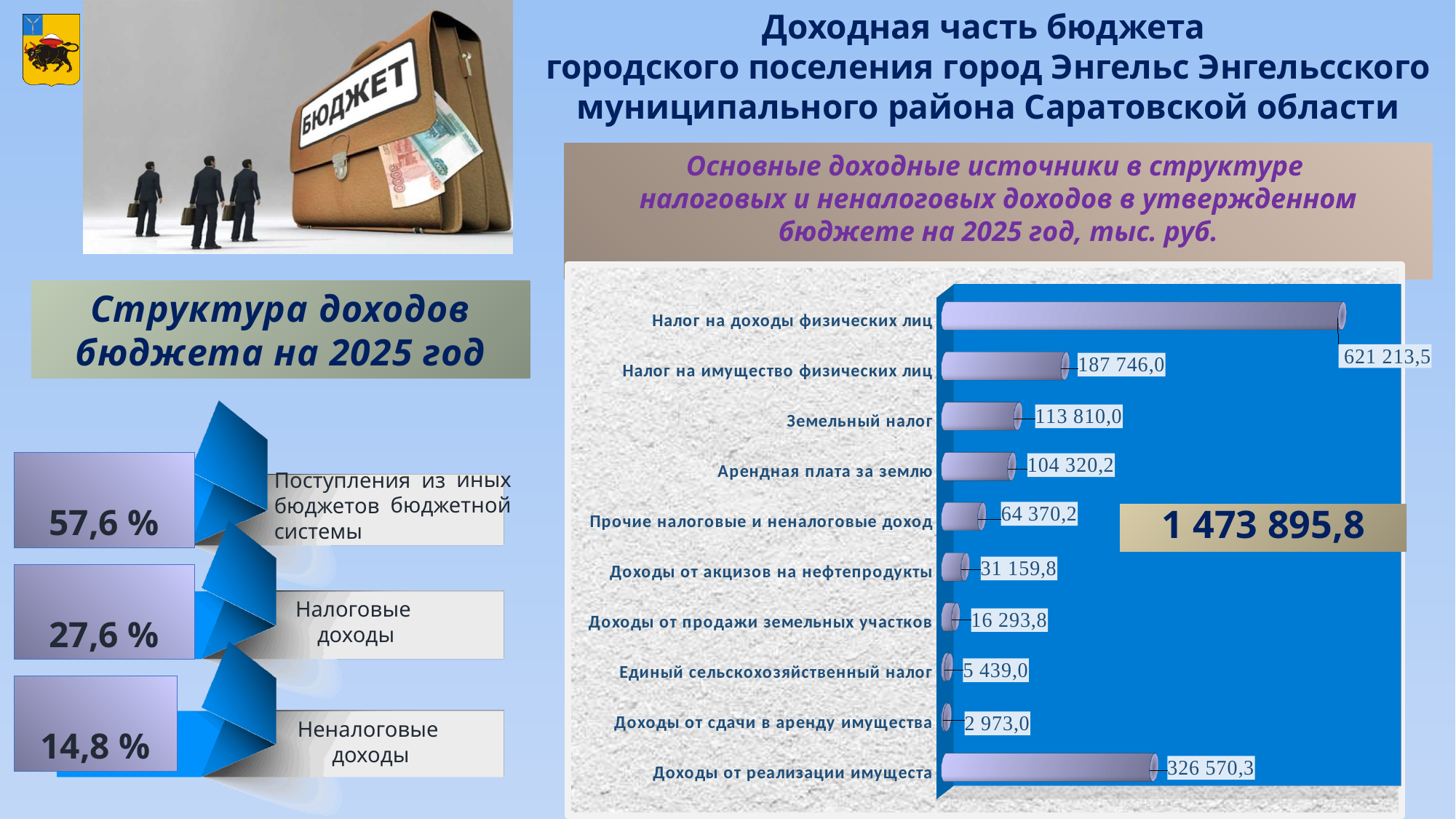
Which category has the lowest value in the bar chart? Доходы от сдачи в аренду имущества What is the value for Налог на доходы физических лиц in the bar chart? 621 213,5 What is the value for Доходы от реализации имущества in the bar chart? 326 570,3 What is the value for Земельный налог in the bar chart? 113 810,0 What total value is printed inside the bar chart area? 1 473 895,8 Which is larger in the bar chart: Арендная плата за землю or Прочие налоговые и неналоговые доход? Арендная плата за землю According to the chart's title, in what units are the values given? тыс. руб. What is the difference between Налог на имущество физических лиц and Земельный налог in the bar chart? 73 936,0 Which category has the highest value in the bar chart? Налог на доходы физических лиц How many categories are plotted in the bar chart? 10 What type of chart is shown on the right side of the slide? bar chart What is the value for Единый сельскохозяйственный налог in the bar chart? 5 439,0